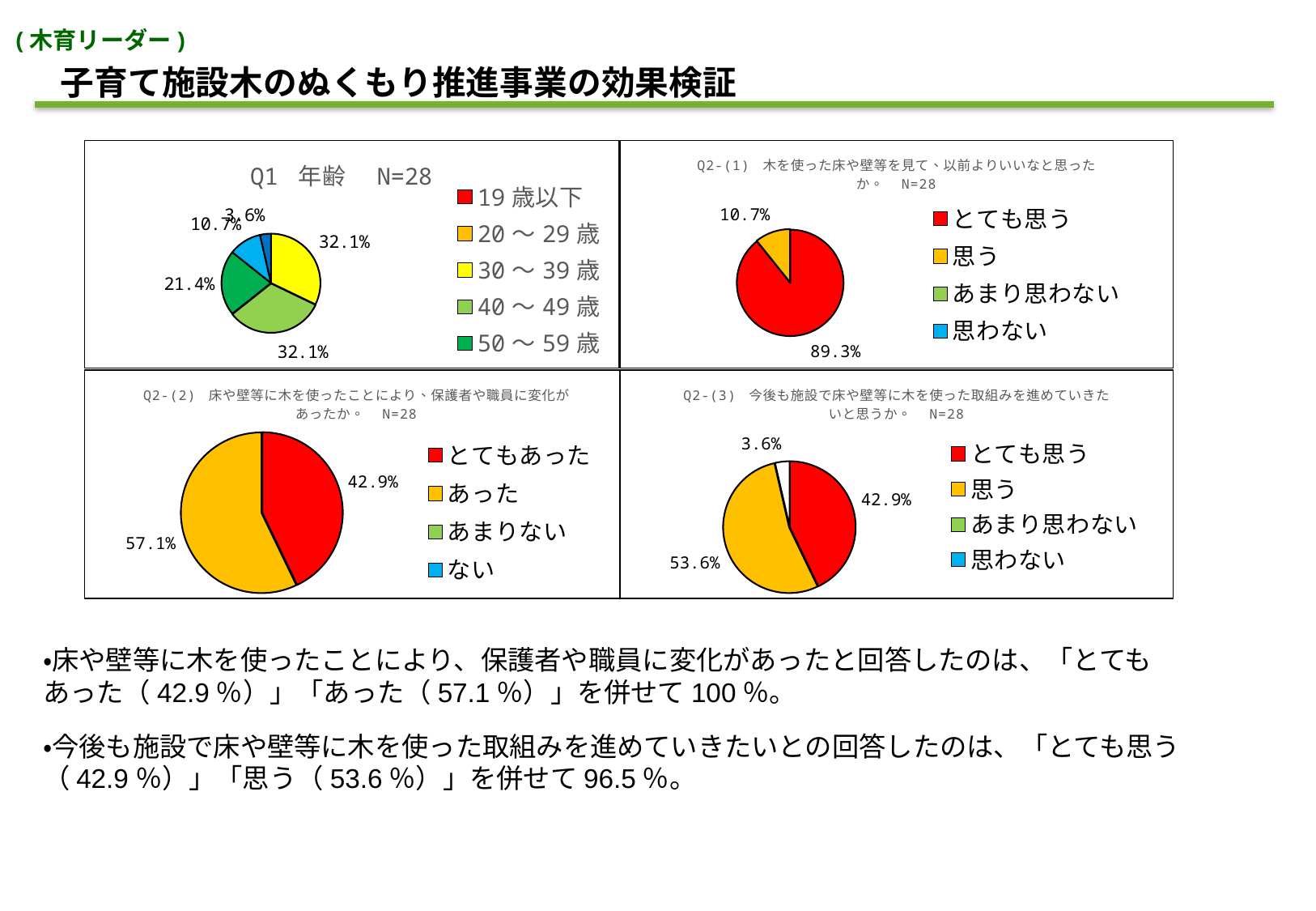
In the Q2-(2) chart (bottom left), which is larger, とてもあった or あった? あった In the Q2-(1) chart (top right), what is the value for とても思う? 89.3% In the Q2-(2) chart (bottom left), what is the difference between あった and とてもあった? 14.2% In the Q2-(3) chart (bottom right), what is the value of the smallest slice? 3.6% What kind of charts are shown on the slide? Pie charts How many charts are on the slide? 4 In the Q2-(1) chart (top right), what is the difference between とても思う and 思う? 78.6% In the Q2-(1) chart (top right), what is the value for 思う? 10.7% In the Q2-(2) chart (bottom left), what is the value for とてもあった? 42.9% In the Q2-(2) chart (bottom left), what is the value for あった? 57.1% In the Q1 年齢 chart (top left), how many entries does the legend list? 5 In the Q2-(3) chart (bottom right), what is the value for 思う? 53.6%